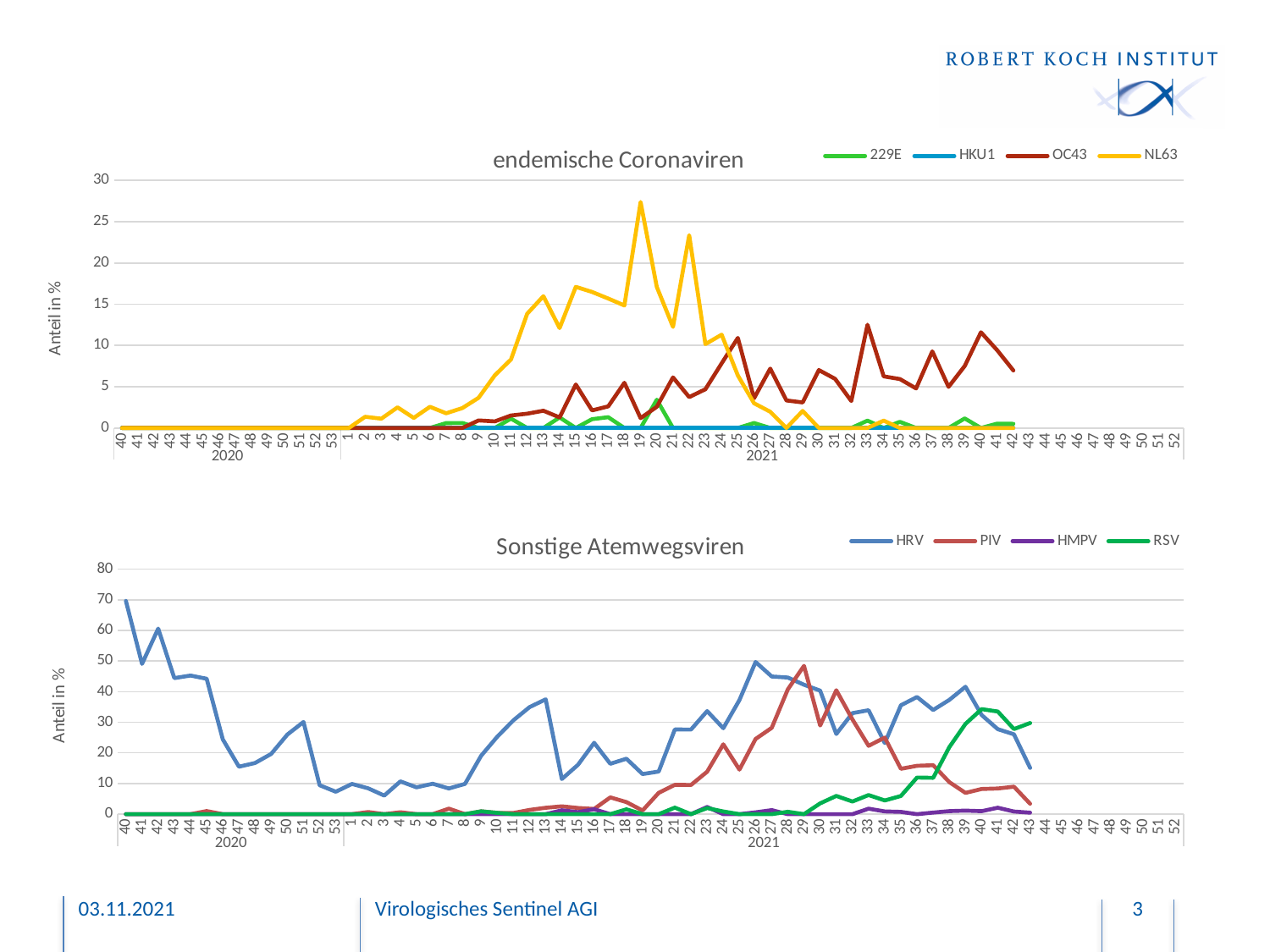
In the bottom chart "Sonstige Atemwegsviren", is the value for HRV in week 40 of 2020 greater or less than 60? greater What type of chart is the top chart titled "endemische Coronaviren"? line chart In the top chart "endemische Coronaviren", is the peak value of NL63 in week 19 of 2021 greater or less than 25? greater In the bottom chart "Sonstige Atemwegsviren", is the peak value of PIV in week 29 of 2021 greater or less than 40? greater In the top chart "endemische Coronaviren", which series reaches the highest value? NL63 Which series are listed in the legend of the bottom chart "Sonstige Atemwegsviren"? HRV, PIV, HMPV, RSV In the bottom chart "Sonstige Atemwegsviren", which series stays lowest across the whole period, HMPV or HRV? HMPV In the bottom chart "Sonstige Atemwegsviren", does the HRV line rise or fall from week 40 to week 47 of 2020? fall In the bottom chart "Sonstige Atemwegsviren", which series reaches the highest value? HRV How many series does the legend of the top chart "endemische Coronaviren" list? 4 What is the y-axis label of the top chart "endemische Coronaviren"? Anteil in % In the top chart "endemische Coronaviren", which series has the higher peak, OC43 or NL63? NL63